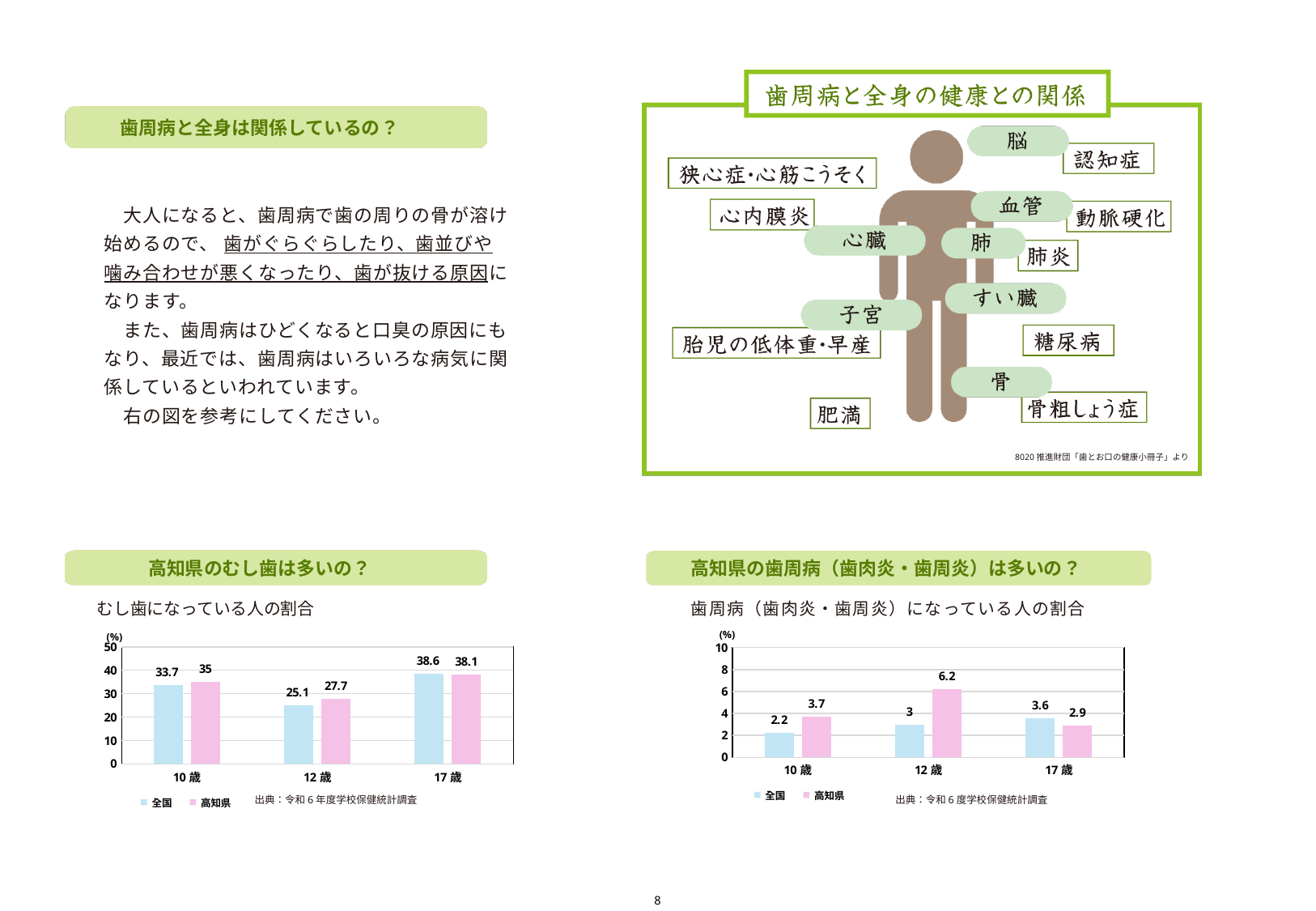
In the chart '歯周病（歯肉炎・歯周炎）になっている人の割合', what is the difference between 高知県 and 全国 at 12歳? 3.2 In the chart 'むし歯になっている人の割合', how many series does the legend list? 2 In the chart '歯周病（歯肉炎・歯周炎）になっている人の割合', at 17歳, which is larger: 全国 or 高知県? 全国 In the chart '歯周病（歯肉炎・歯周炎）になっている人の割合', what is the value for 全国 at 10歳? 2.2 In the chart 'むし歯になっている人の割合', what is the difference between 高知県 and 全国 at 10歳? 1.3 In the chart 'むし歯になっている人の割合', which age group has the lowest value for 全国? 12歳 In the chart '歯周病（歯肉炎・歯周炎）になっている人の割合', what is the value for 高知県 at 12歳? 6.2 In the chart 'むし歯になっている人の割合', what kind of chart is shown? bar chart In the chart 'むし歯になっている人の割合', what is the value for 全国 at 17歳? 38.6 In the chart '歯周病（歯肉炎・歯周炎）になっている人の割合', how many age groups are shown on the x axis? 3 In the chart 'むし歯になっている人の割合', what is the value for 高知県 at 12歳? 27.7 In the chart '歯周病（歯肉炎・歯周炎）になっている人の割合', which age group has the highest value for 高知県? 12歳